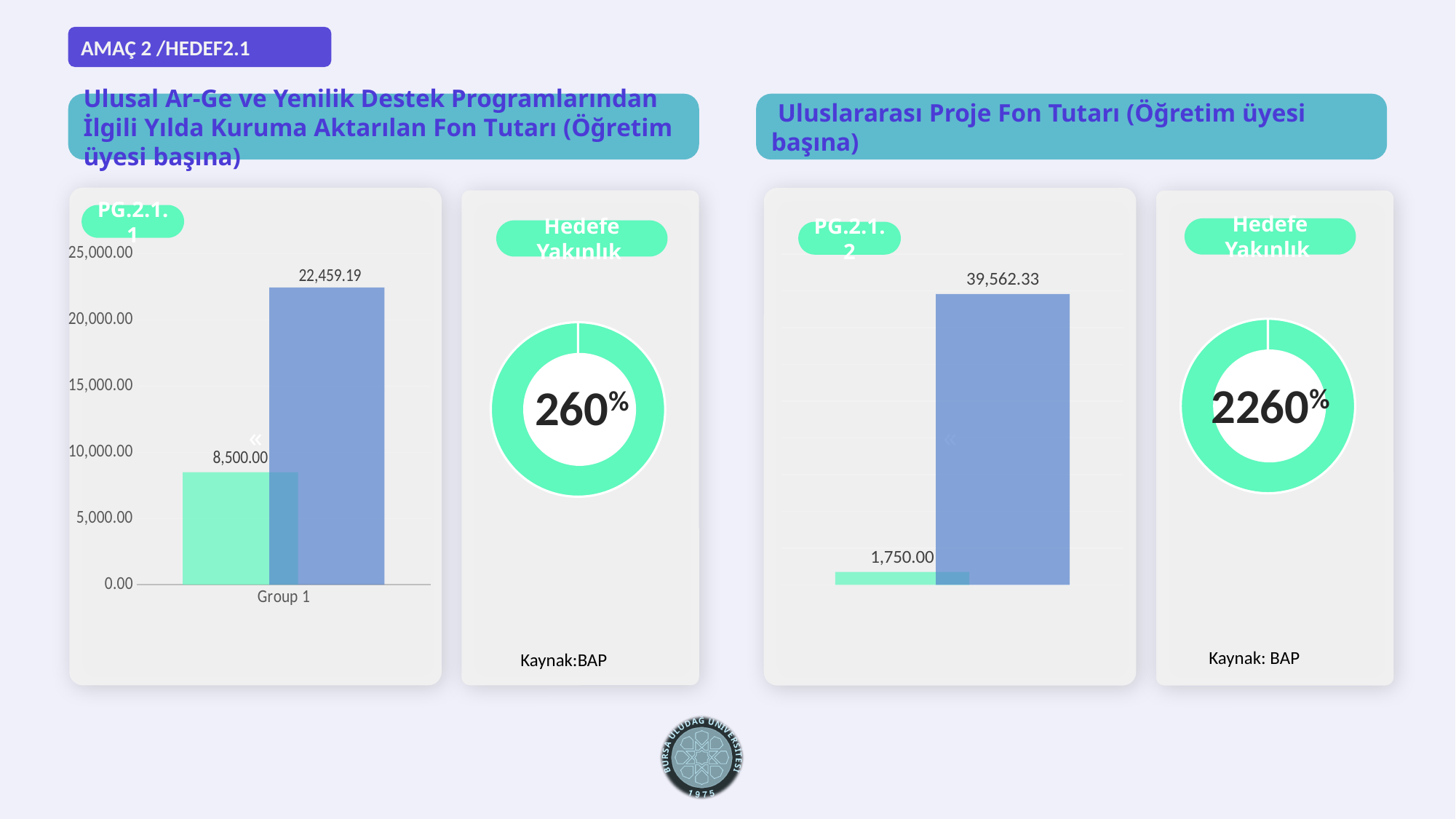
What percentage is shown in the left 'Hedefe Yakınlık' donut chart? 260% In the PG.2.1.1 bar chart, is the value of the blue bar greater or less than 20,000.00? greater What type of chart is the PG.2.1.1 chart? bar chart In the PG.2.1.1 bar chart, is the value of the green bar greater or less than 10,000.00? less In the PG.2.1.1 bar chart, what is the difference between the blue bar value and the green bar value? 13,959.19 In the PG.2.1.2 bar chart, what is the difference between the blue bar value and the green bar value? 37,812.33 In the PG.2.1.1 bar chart, what value is printed on the taller (blue) bar? 22,459.19 In the PG.2.1.1 bar chart, which bar is larger, the blue bar or the green bar? the blue bar In the PG.2.1.2 bar chart, what value is printed on the shorter (green) bar? 1,750.00 What percentage is shown in the right 'Hedefe Yakınlık' donut chart? 2260% In the PG.2.1.2 bar chart, what value is printed on the taller (blue) bar? 39,562.33 In the PG.2.1.1 bar chart, what value is printed on the shorter (green) bar? 8,500.00